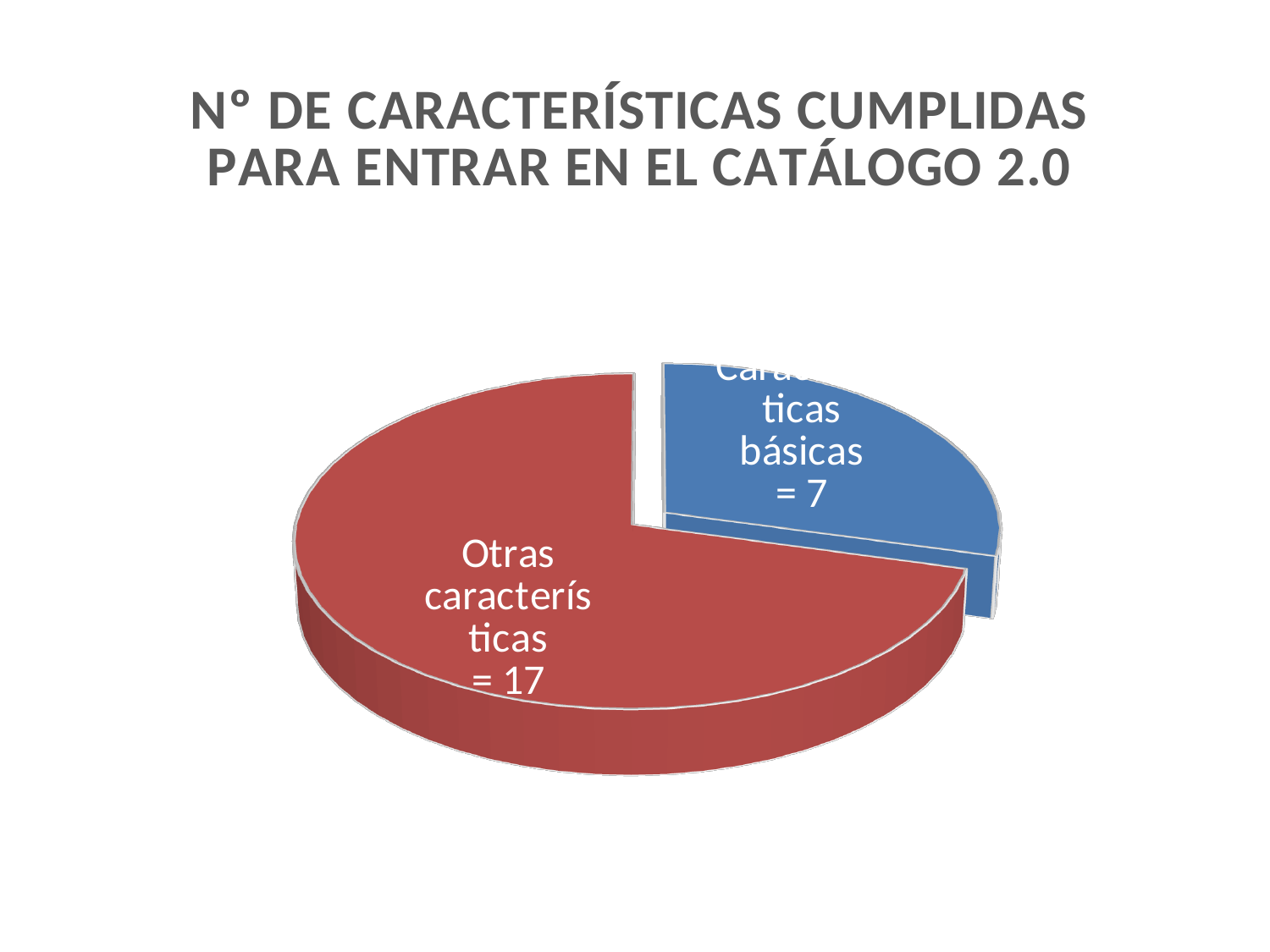
What is the total of the two slices in the pie chart? 24 What colour is the "Otras características" slice? Red Which slice is the smallest? Características básicas What is the difference between the values for "Otras características" and "Características básicas"? 10 What kind of chart is shown on the slide? Pie chart How many slices does the pie chart have? 2 What is the value for "Características básicas"? 7 Which slice is the largest? Otras características What is the title of the chart? Nº DE CARACTERÍSTICAS CUMPLIDAS PARA ENTRAR EN EL CATÁLOGO 2.0 What is the value for "Otras características"? 17 Which is larger, "Otras características" or "Características básicas"? Otras características